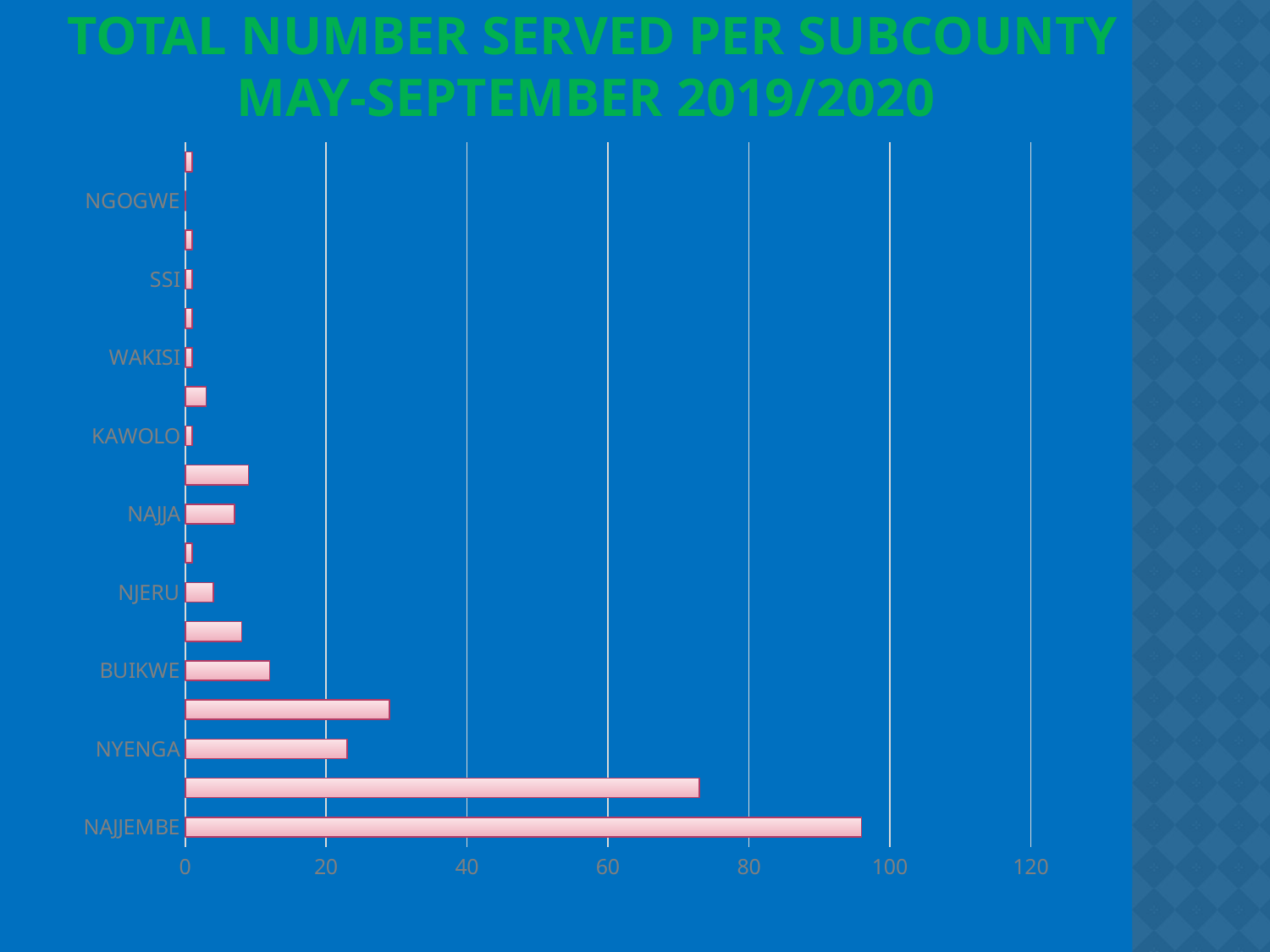
How many subcounties are listed on the vertical axis of the chart? 9 Is the longer bar for NYENGA greater or less than 20? greater Is the longest bar for NAJJEMBE greater or less than 80? greater Which subcounty has the longest bar in the chart? NAJJEMBE What kind of chart is shown on the slide? bar chart What is the title of the chart? TOTAL NUMBER SERVED PER SUBCOUNTY MAY-SEPTEMBER 2019/2020 Is the longer bar for NAJJA greater or less than 20? less Which subcounty has longer bars, NYENGA or BUIKWE? NYENGA Which subcounty has longer bars, NAJJEMBE or NYENGA? NAJJEMBE What is the highest value shown on the horizontal axis of the chart? 120